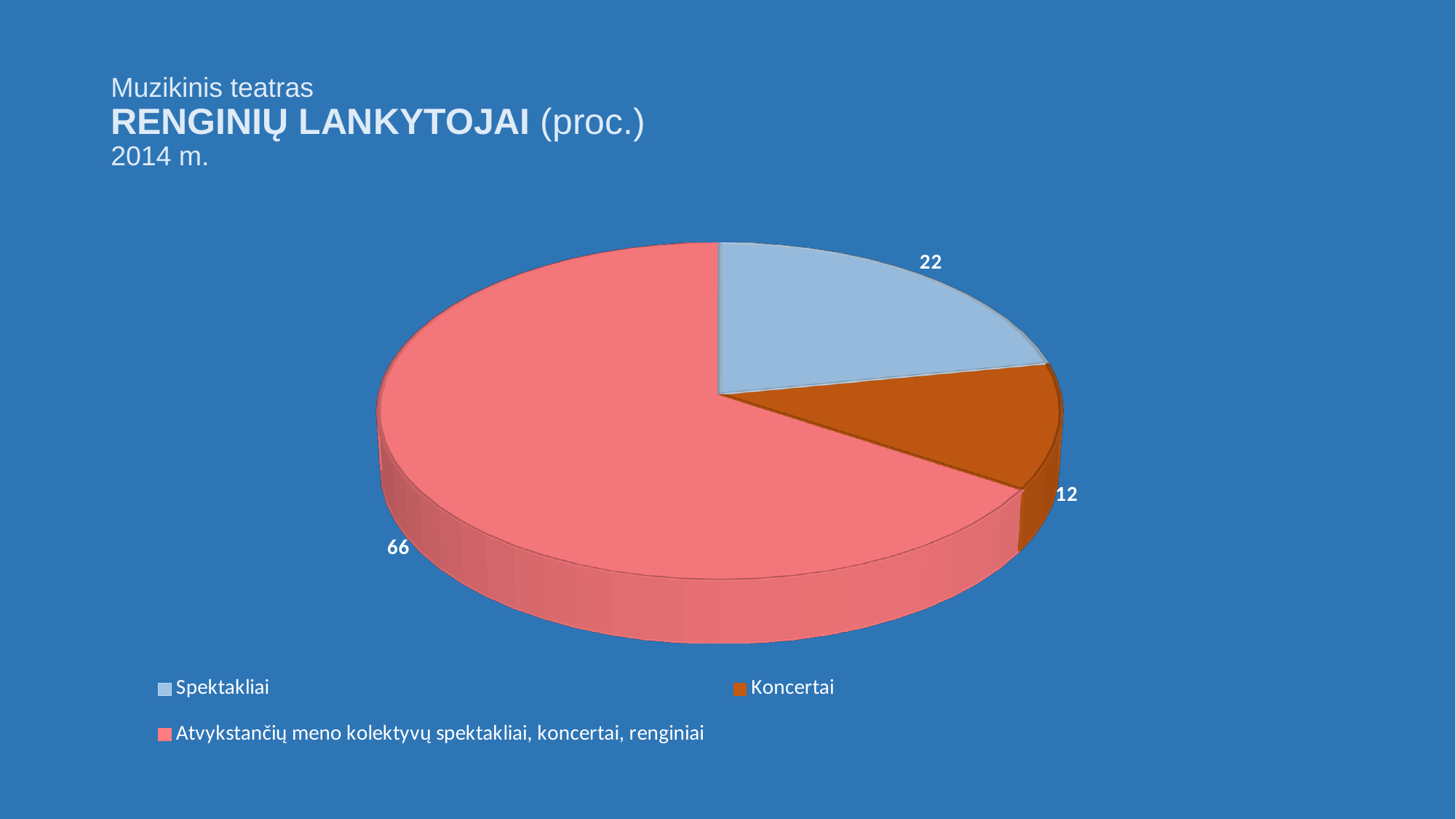
Which category has the largest slice of the pie? Atvykstančių meno kolektyvų spektakliai, koncertai, renginiai What is the total of the three slice values shown? 100 What year does the chart title refer to? 2014 m. What is the difference between the values for Spektakliai and Koncertai? 10 What value is shown for the Spektakliai slice? 22 What is the difference between the largest slice and the Spektakliai slice? 44 How many slices does the pie chart have? 3 Which is larger, the Spektakliai slice or the Koncertai slice? Spektakliai What value is shown for the Koncertai slice? 12 Which category has the smallest slice of the pie? Koncertai What kind of chart is shown on the slide? Pie chart What value is shown for the slice labelled Atvykstančių meno kolektyvų spektakliai, koncertai, renginiai? 66